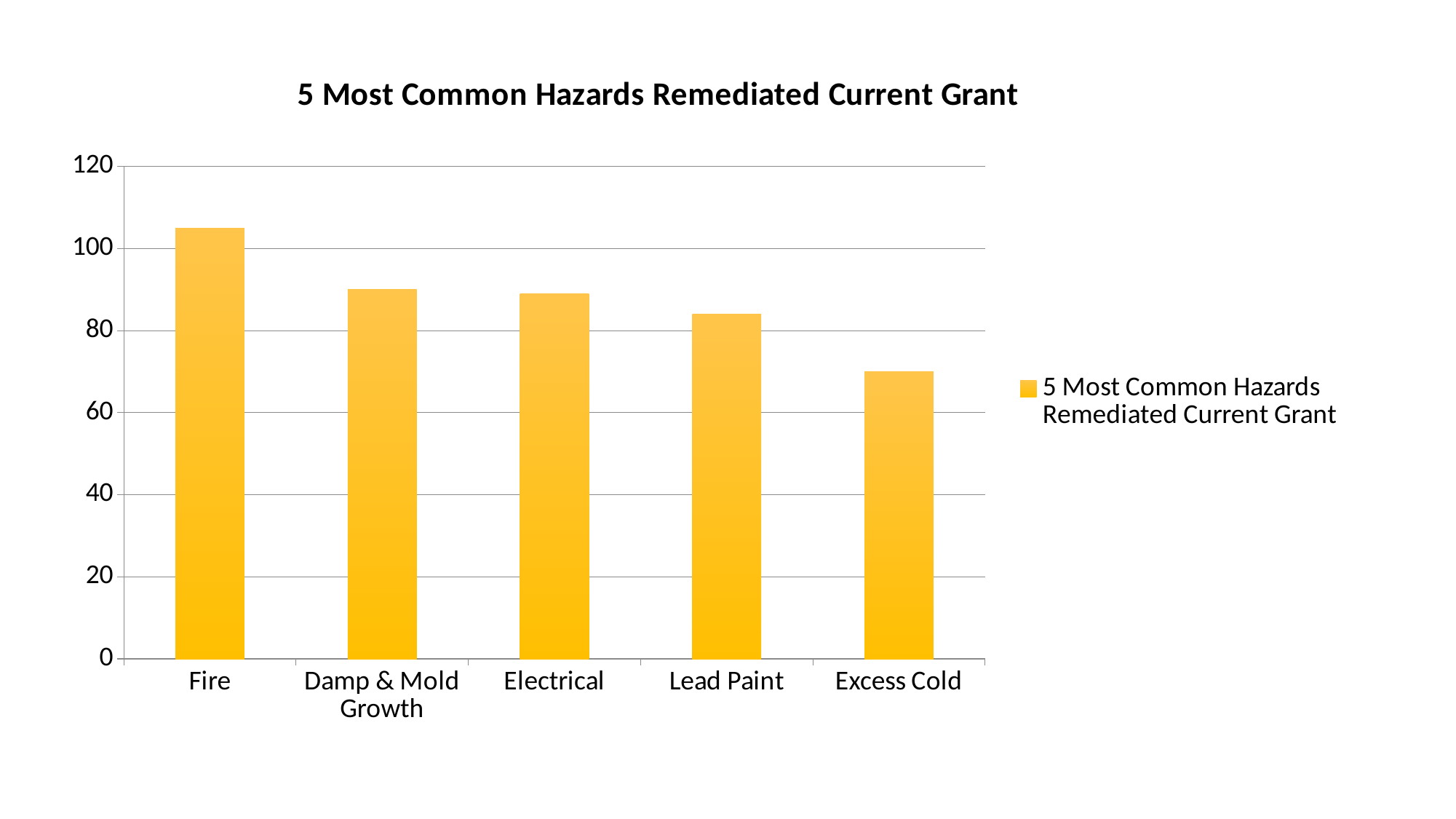
Which hazard category has the highest value? Fire Which is larger, the value for Lead Paint or the value for Excess Cold? Lead Paint Do the values rise or fall moving from Fire to Excess Cold along the x axis? fall What kind of chart is shown on the slide? bar chart Is the value for Fire greater or less than 100? greater Which hazard category has the lowest value? Excess Cold What is the title of the chart? 5 Most Common Hazards Remediated Current Grant Is the value for Excess Cold greater or less than 80? less How many hazard categories are plotted on the chart? 5 Is the value for Electrical greater or less than 100? less How many series does the legend list? 1